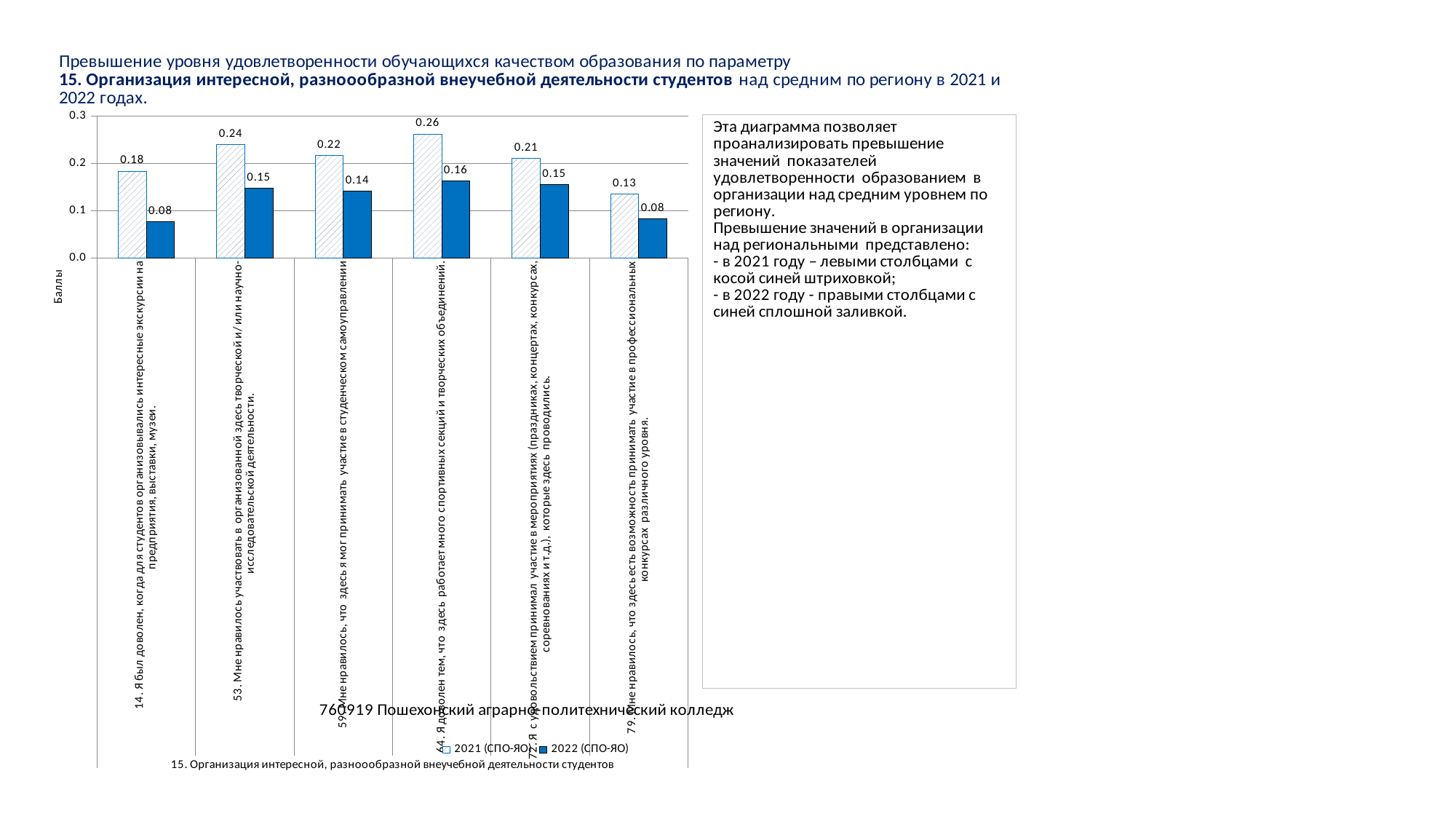
What is the label of the vertical axis of the chart? Баллы What is the 2022 (СПО-ЯО) value for statement 53 ("Мне нравилось участвовать в организованной здесь творческой и/или научно-исследовательской деятельности")? 0.15 Which statement has the lowest 2021 (СПО-ЯО) value? Мне нравилось, что здесь есть возможность принимать участие в профессиональных конкурсах различного уровня Which statement has the highest 2021 (СПО-ЯО) value? Я доволен тем, что здесь работает много спортивных секций и творческих объединений Is the 2022 (СПО-ЯО) value for statement 14 ("Я был доволен, когда для студентов организовывались интересные экскурсии...") greater or less than 0.1? less What type of chart is shown on the slide? bar chart How many series does the chart legend list? 2 What is the 2021 (СПО-ЯО) value for statement 14 ("Я был доволен, когда для студентов организовывались интересные экскурсии на предприятия, выставки, музеи")? 0.18 What is the 2021 (СПО-ЯО) value for the statement about sports sections and creative associations ("Я доволен тем, что здесь работает много спортивных секций и творческих объединений")? 0.26 How many categories (statements) are plotted on the chart? 6 For the statement about participating in student self-government ("Мне нравилось, что здесь я мог принимать участие в студенческом самоуправлении"), which series has the larger value, 2021 (СПО-ЯО) or 2022 (СПО-ЯО)? 2021 (СПО-ЯО) What is the difference between the 2021 and 2022 values for statement 53 ("Мне нравилось участвовать в организованной здесь творческой и/или научно-исследовательской деятельности")? 0.09